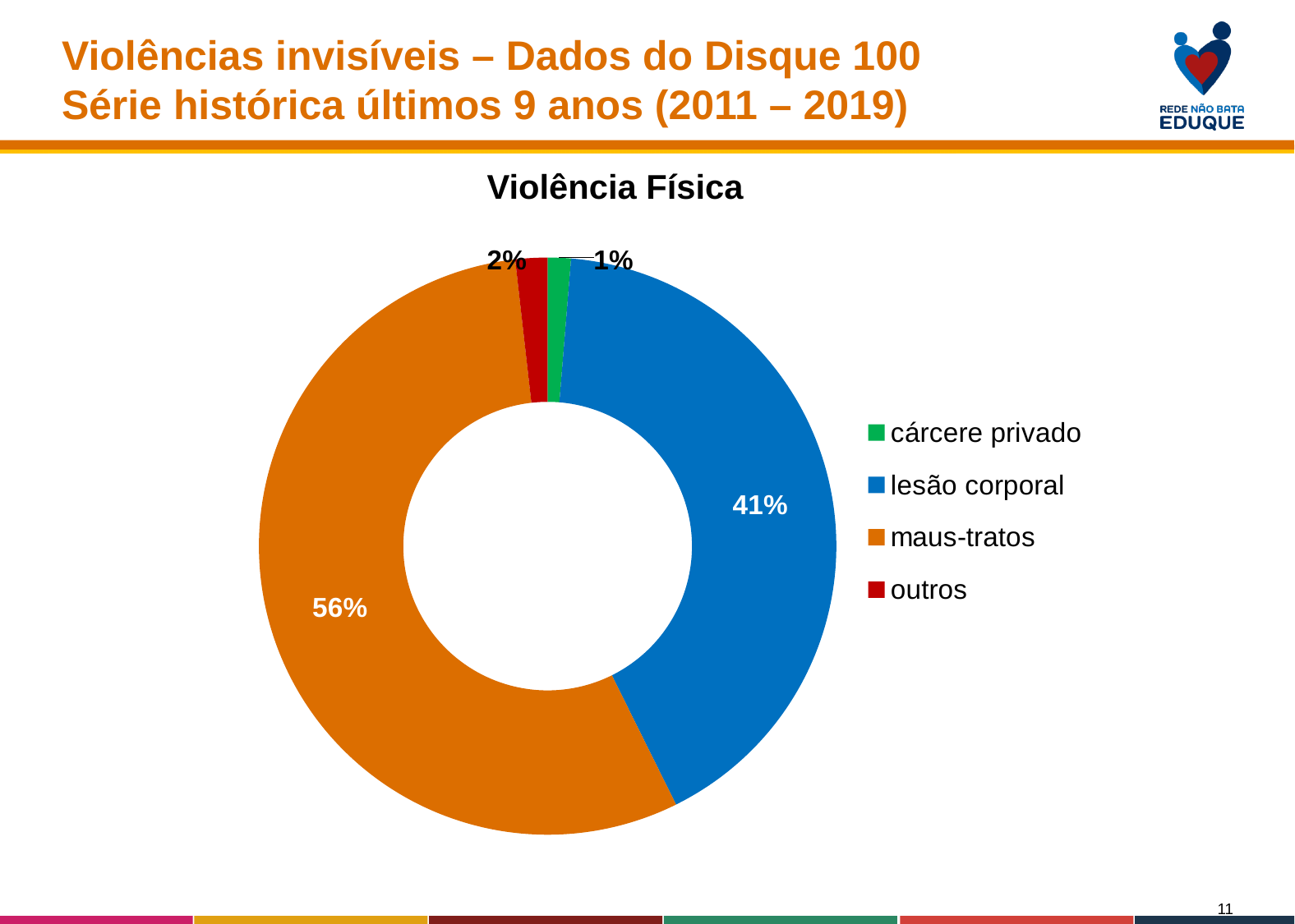
Which has a larger share in the Violência Física chart, outros or cárcere privado? outros Which colour represents lesão corporal in the Violência Física chart? blue What is the difference in percentage points between maus-tratos and lesão corporal in the Violência Física chart? 15 What is the share for lesão corporal in the Violência Física chart? 41% How many categories are shown in the Violência Física chart? 4 What kind of chart is the Violência Física chart? doughnut chart Which category has the largest share in the Violência Física chart? maus-tratos What is the share for outros in the Violência Física chart? 2% What is the share for cárcere privado in the Violência Física chart? 1% What is the title of the chart on the slide? Violência Física What is the share for maus-tratos in the Violência Física chart? 56% Which category has the smallest share in the Violência Física chart? cárcere privado